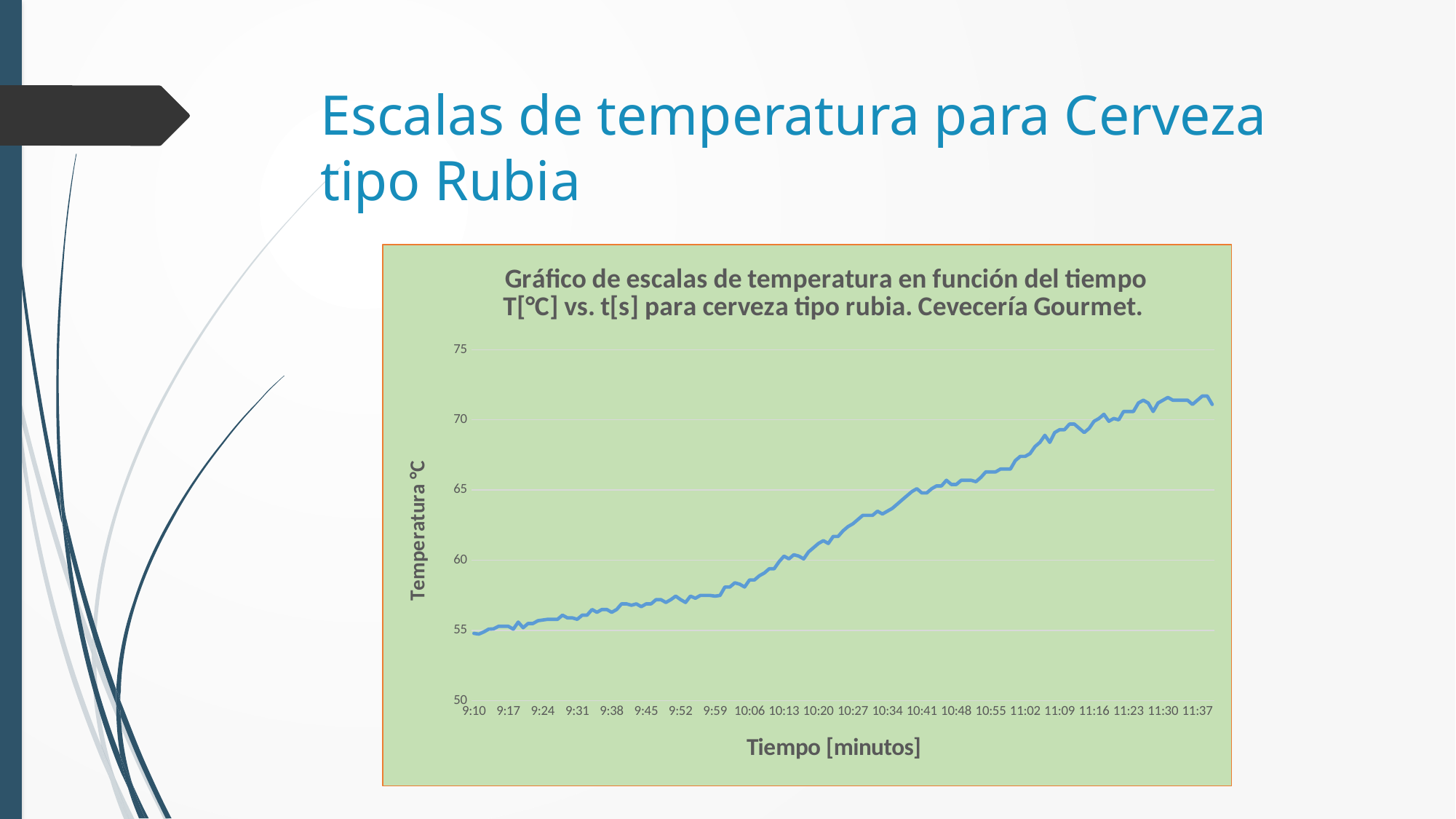
What is the highest tick value shown on the y axis? 75 What kind of chart is shown on the slide? Line chart Does the temperature rise or fall along the x axis from 9:10 to 11:37? Rises Is the temperature value at 9:59 greater or less than 60? less Is the temperature value at 10:41 greater or less than 60? greater What is the label of the x axis? Tiempo [minutos] What is the label of the y axis? Temperatura °C Is the temperature value at 11:37 greater or less than 70? greater Which is larger, the temperature at 9:10 or the temperature at 11:37? 11:37